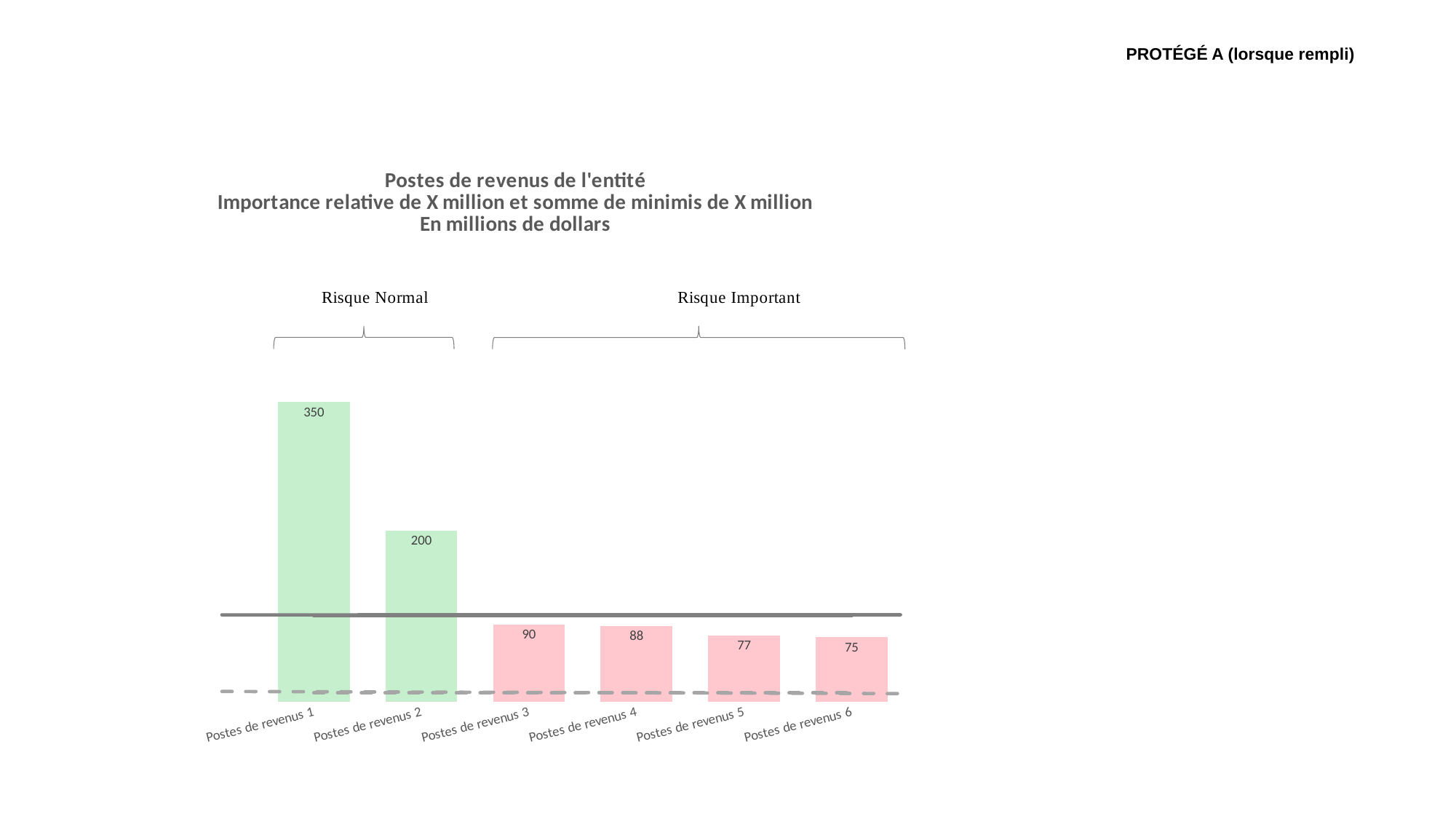
What is the value for Postes de revenus 6? 75 Which category has the highest value? Postes de revenus 1 What is the value for Postes de revenus 1? 350 What is the difference between the values for Postes de revenus 1 and Postes de revenus 2? 150 Which group label covers Postes de revenus 3 to 6? Risque Important How many categories are shown on the x axis? 6 Which category has the lowest value? Postes de revenus 6 Which is larger, the value for Postes de revenus 3 or Postes de revenus 4? Postes de revenus 3 What is the value for Postes de revenus 4? 88 Do the values rise or fall from left to right along the x axis? fall What kind of chart is this? bar chart What is the difference between the values for Postes de revenus 3 and Postes de revenus 5? 13